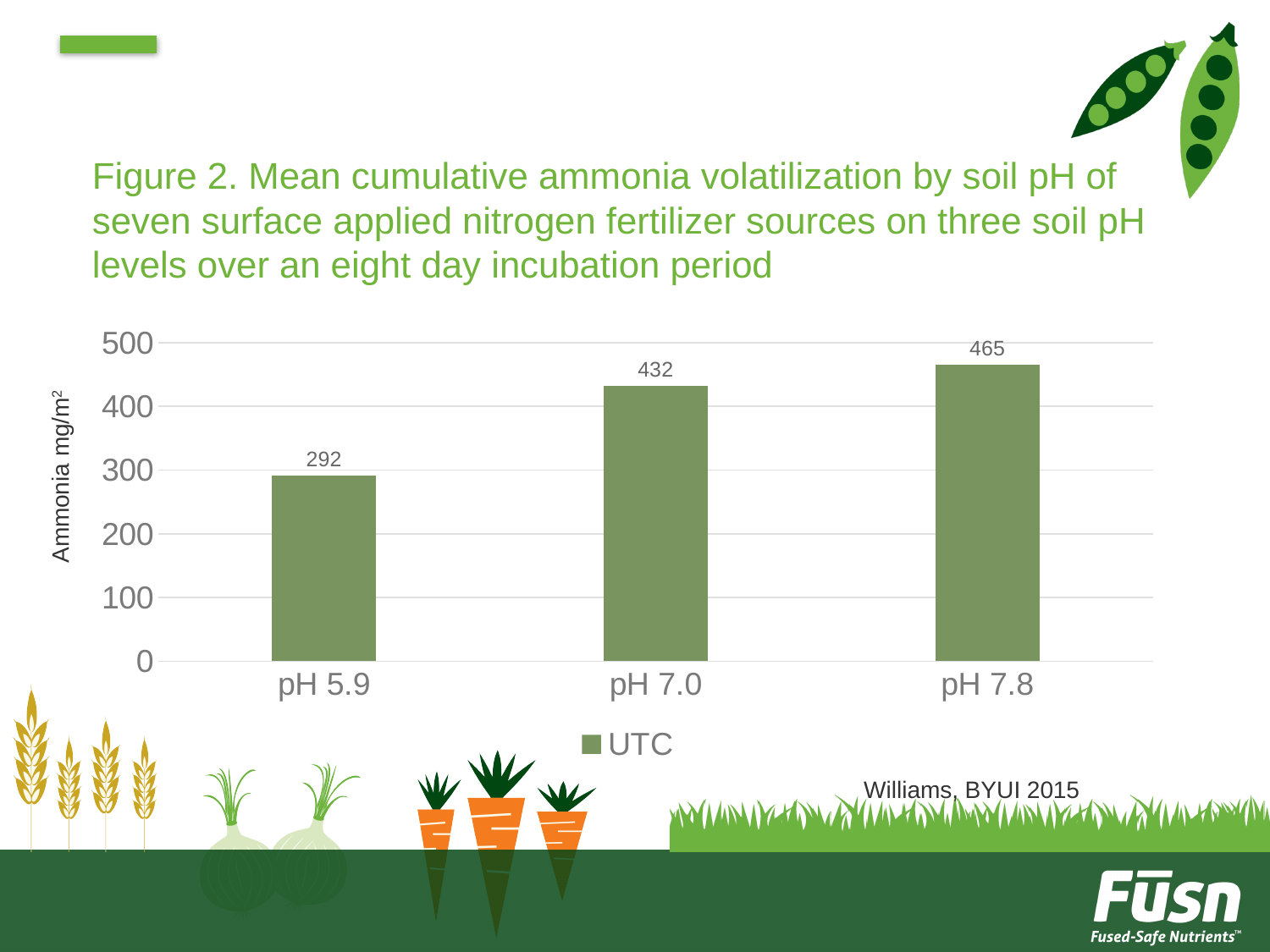
Which is larger, the value for pH 7.0 or the value for pH 5.9? pH 7.0 Which soil pH level has the lowest ammonia volatilization? pH 5.9 How many soil pH categories are shown on the x axis? 3 Is the value for pH 7.8 greater or less than 400? greater Which soil pH level has the highest ammonia volatilization? pH 7.8 Do the values rise or fall as soil pH increases along the x axis? rise What is the ammonia value for pH 5.9? 292 What is the ammonia value for pH 7.0? 432 What is the difference between the values for pH 7.0 and pH 5.9? 140 What kind of chart is shown on the slide? bar chart What is the ammonia value for pH 7.8? 465 What is the difference between the values for pH 7.8 and pH 5.9? 173